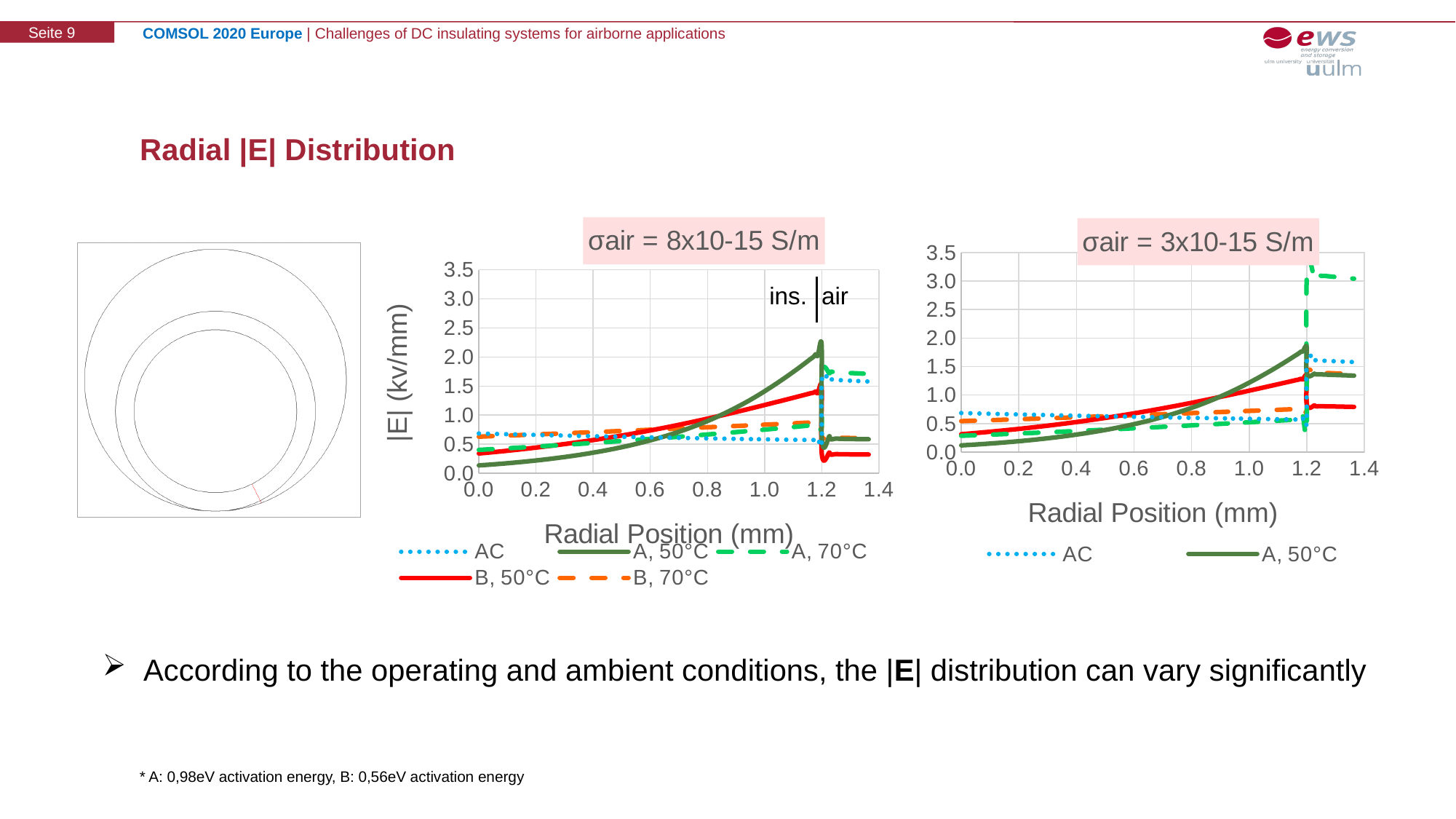
What kind of chart is the left chart titled "σair = 8x10-15 S/m"? line chart In the left chart (σair = 8x10-15 S/m), at a radial position of 1.0 mm, which is larger: A, 50°C or B, 50°C? A, 50°C What is the y-axis label of the left chart (σair = 8x10-15 S/m)? |E| (kv/mm) In the left chart (σair = 8x10-15 S/m), how many series does the legend list? 5 In the left chart (σair = 8x10-15 S/m), does the A, 50°C line rise or fall as the radial position goes from 0.0 to 1.2 mm? rise In the right chart (σair = 3x10-15 S/m), is the AC value at 1.4 mm greater or less than 1.0? greater In the left chart (σair = 8x10-15 S/m), is the peak value of the A, 50°C line near 1.2 mm greater or less than 2.0? greater In the right chart (σair = 3x10-15 S/m), at a radial position of 0.2 mm, which is larger: AC or A, 50°C? AC In the left chart (σair = 8x10-15 S/m), is the value of B, 50°C just before 1.2 mm greater or less than 1.0? greater In the right chart (σair = 3x10-15 S/m), how many series does the legend list? 2